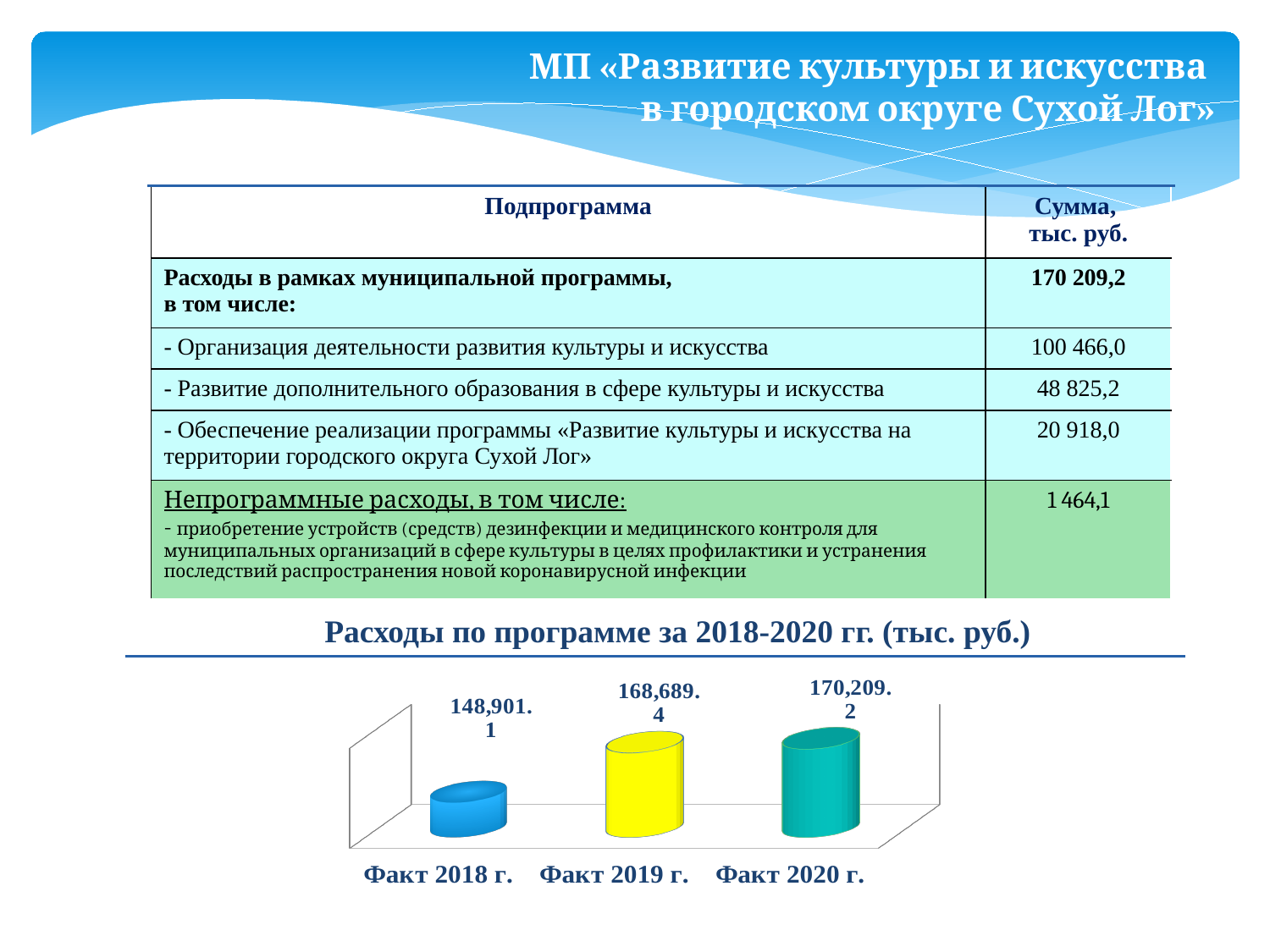
What is the difference between the values for Факт 2020 г. and Факт 2018 г.? 21,308.1 What is the value for Факт 2019 г. in the chart? 168,689.4 What is the title of the chart? Расходы по программе за 2018-2020 гг. (тыс. руб.) Which category has the highest value in the chart? Факт 2020 г. Which category has the lowest value in the chart? Факт 2018 г. What is the value for Факт 2018 г. in the chart? 148,901.1 What is the difference between the values for Факт 2019 г. and Факт 2018 г.? 19,788.3 Which is larger, the value for Факт 2019 г. or Факт 2020 г.? Факт 2020 г. What kind of chart is shown on the slide? Bar chart Do the values rise or fall from Факт 2018 г. to Факт 2020 г.? Rise What is the value for Факт 2020 г. in the chart? 170,209.2 How many categories are shown in the chart? 3